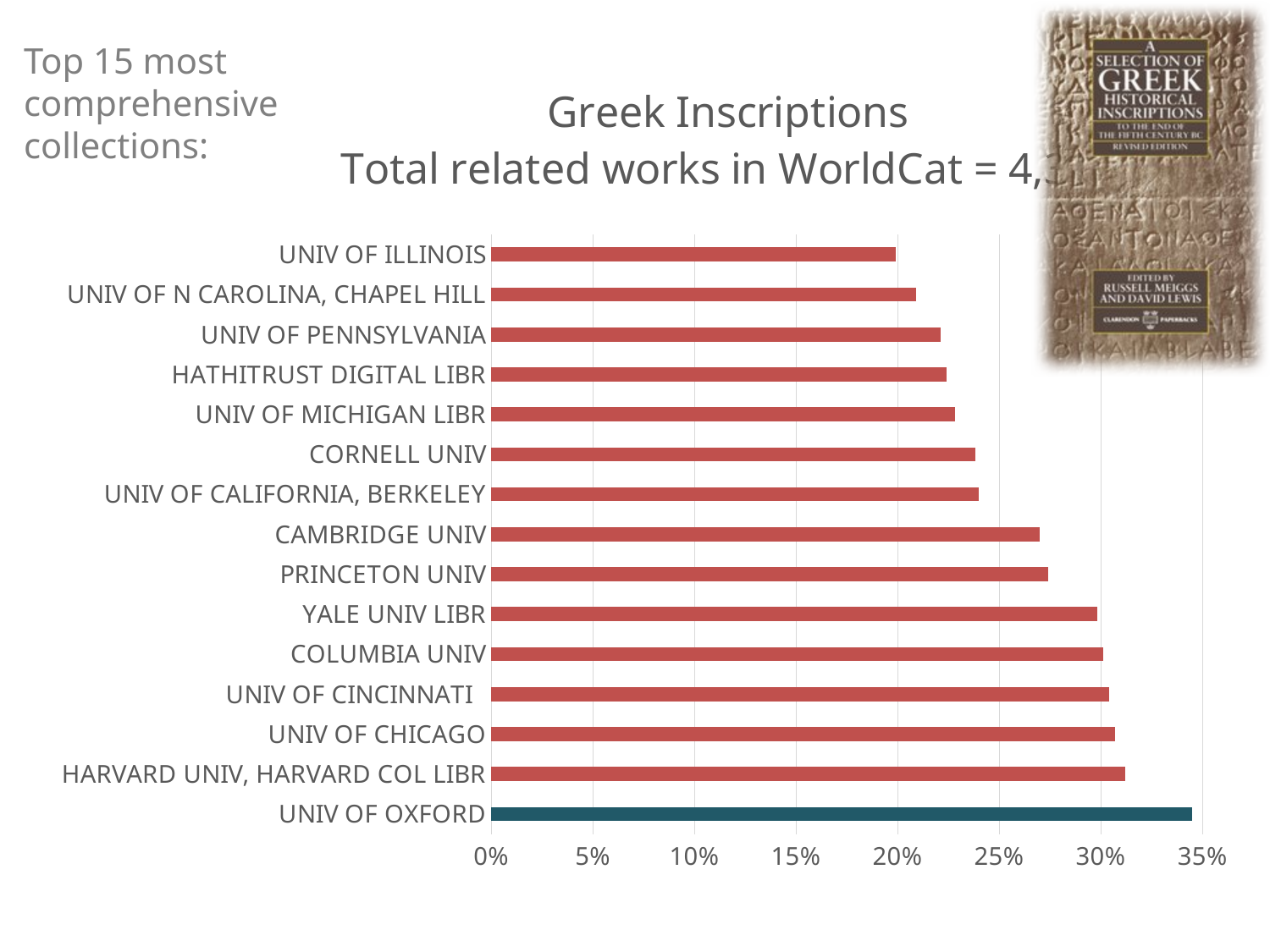
Is the value for CAMBRIDGE UNIV greater or less than 25%? greater Which has a larger value, CAMBRIDGE UNIV or UNIV OF MICHIGAN LIBR? CAMBRIDGE UNIV Is the value for UNIV OF OXFORD greater or less than 30%? greater What kind of chart is shown on the slide? Bar chart Which institution has the lowest value in the chart? UNIV OF ILLINOIS Is the value for CORNELL UNIV greater or less than 25%? less Which bar in the chart is shown in a different colour from the others? UNIV OF OXFORD Which institution has the highest value in the chart? UNIV OF OXFORD Which has a larger value, UNIV OF OXFORD or UNIV OF CHICAGO? UNIV OF OXFORD How many institutions are listed in the chart? 15